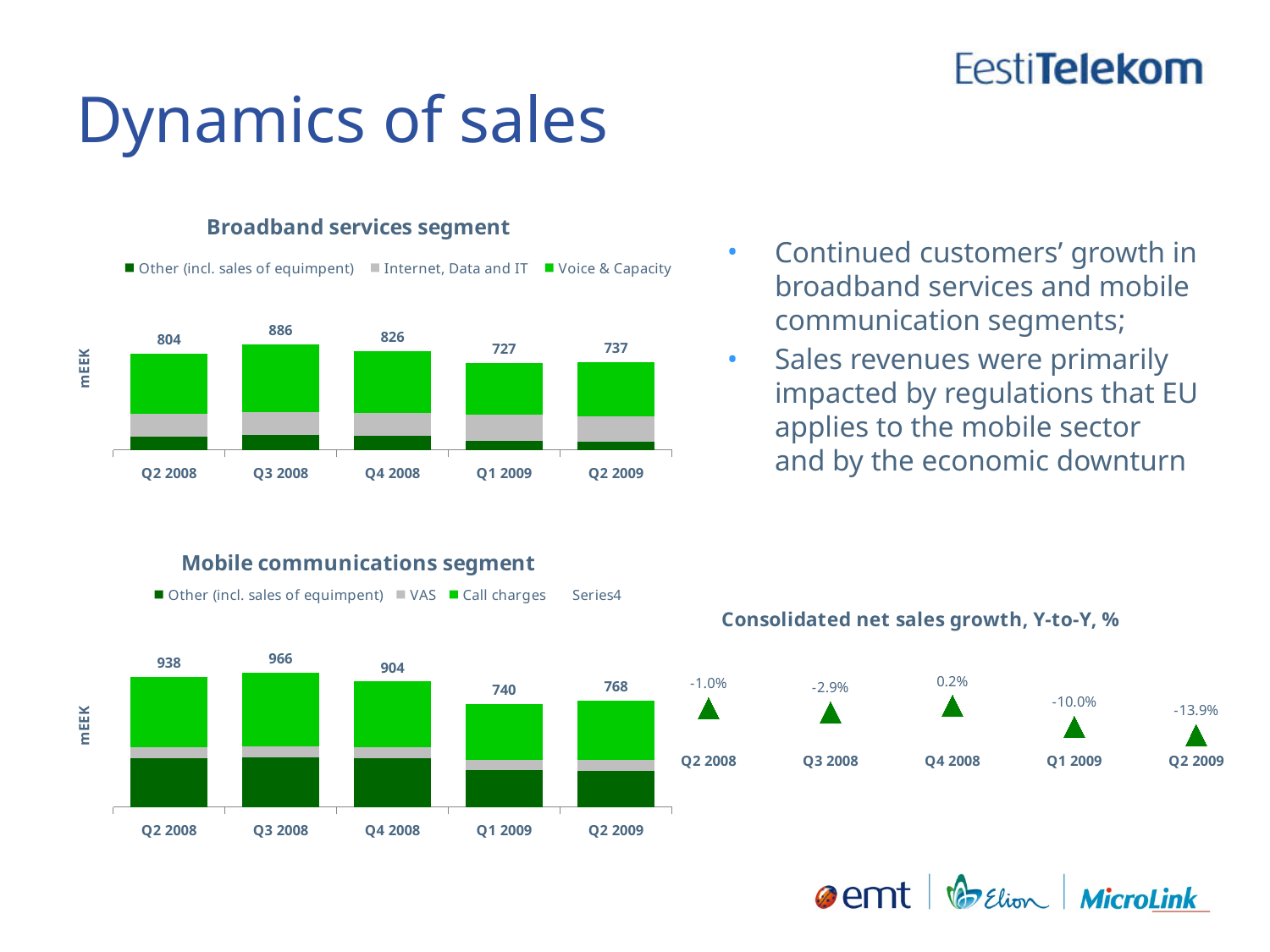
What kind of chart is the Mobile communications segment chart? Stacked bar chart In the Mobile communications segment chart, how many quarters are shown on the x axis? 5 In the Mobile communications segment chart, which quarter has the highest total? Q3 2008 What unit is shown on the y axis of the Broadband services segment chart? mEEK In the Mobile communications segment chart, what is the total value labelled for Q4 2008? 904 In the Consolidated net sales growth, Y-to-Y, % chart, what is the value for Q1 2009? -10.0% In the Broadband services segment chart, which quarter has the lowest total? Q1 2009 In the Mobile communications segment chart, is the total for Q1 2009 or Q2 2009 larger? Q2 2009 In the Consolidated net sales growth, Y-to-Y, % chart, which quarter has the highest value? Q4 2008 In the Broadband services segment chart, how many series does the legend list? 3 In the Broadband services segment chart, what is the total value labelled for Q3 2008? 886 In the Broadband services segment chart, what is the difference between the Q3 2008 total and the Q2 2009 total? 149